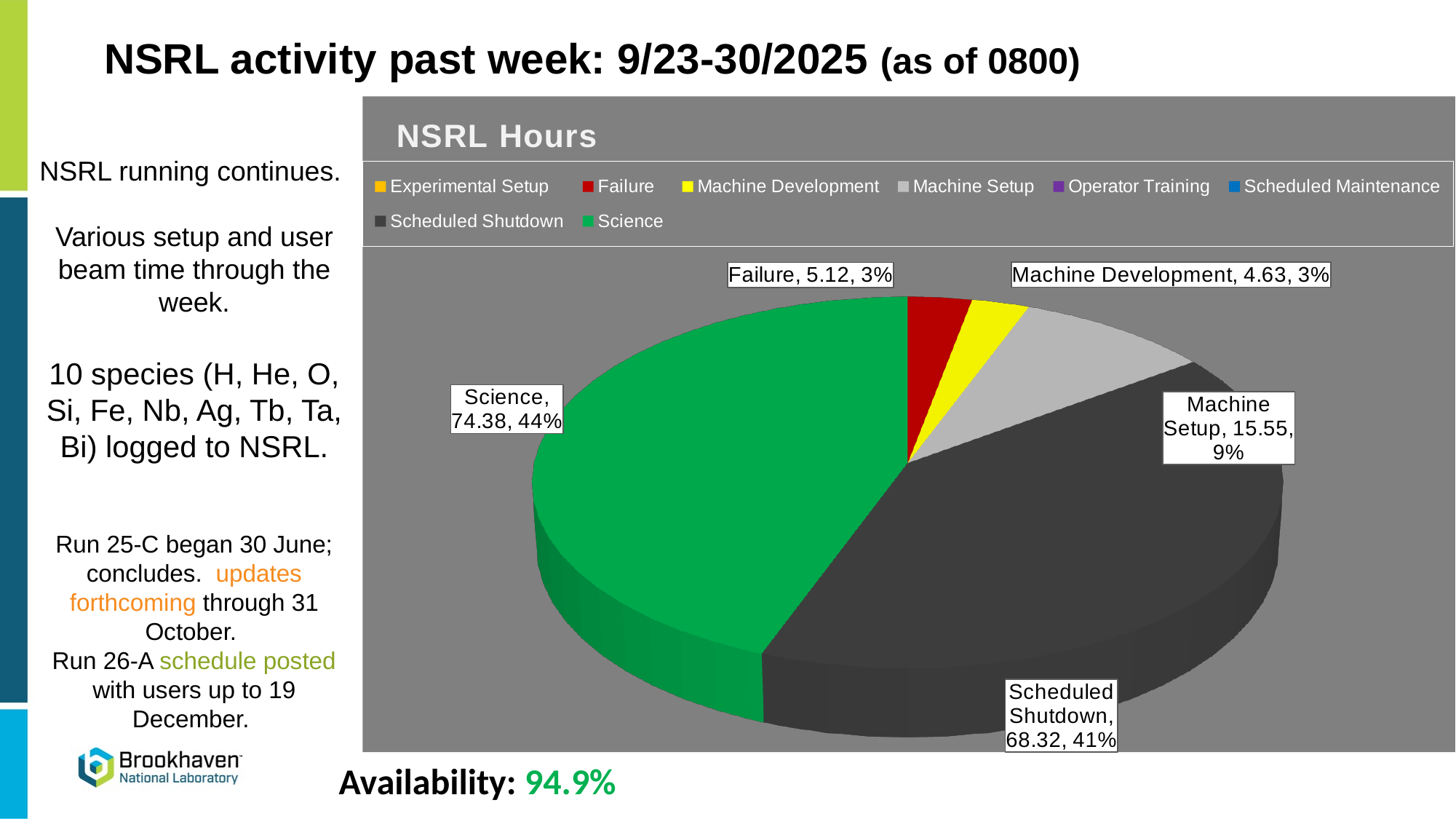
Which labeled category has the largest slice of the pie? Science Which labeled category has the smallest slice of the pie? Machine Development How many hours are labeled for Science? 74.38 What percentage share of the pie does Science have? 44% How many hours are labeled for Machine Setup? 15.55 What kind of chart is shown on the slide? pie chart What is the title of the chart? NSRL Hours How many hours are labeled for Scheduled Shutdown? 68.32 What is the difference in hours between Science and Scheduled Shutdown? 6.06 How many hours are labeled for Failure? 5.12 How many entries does the chart's legend list? 8 What percentage share of the pie does Machine Setup have? 9%